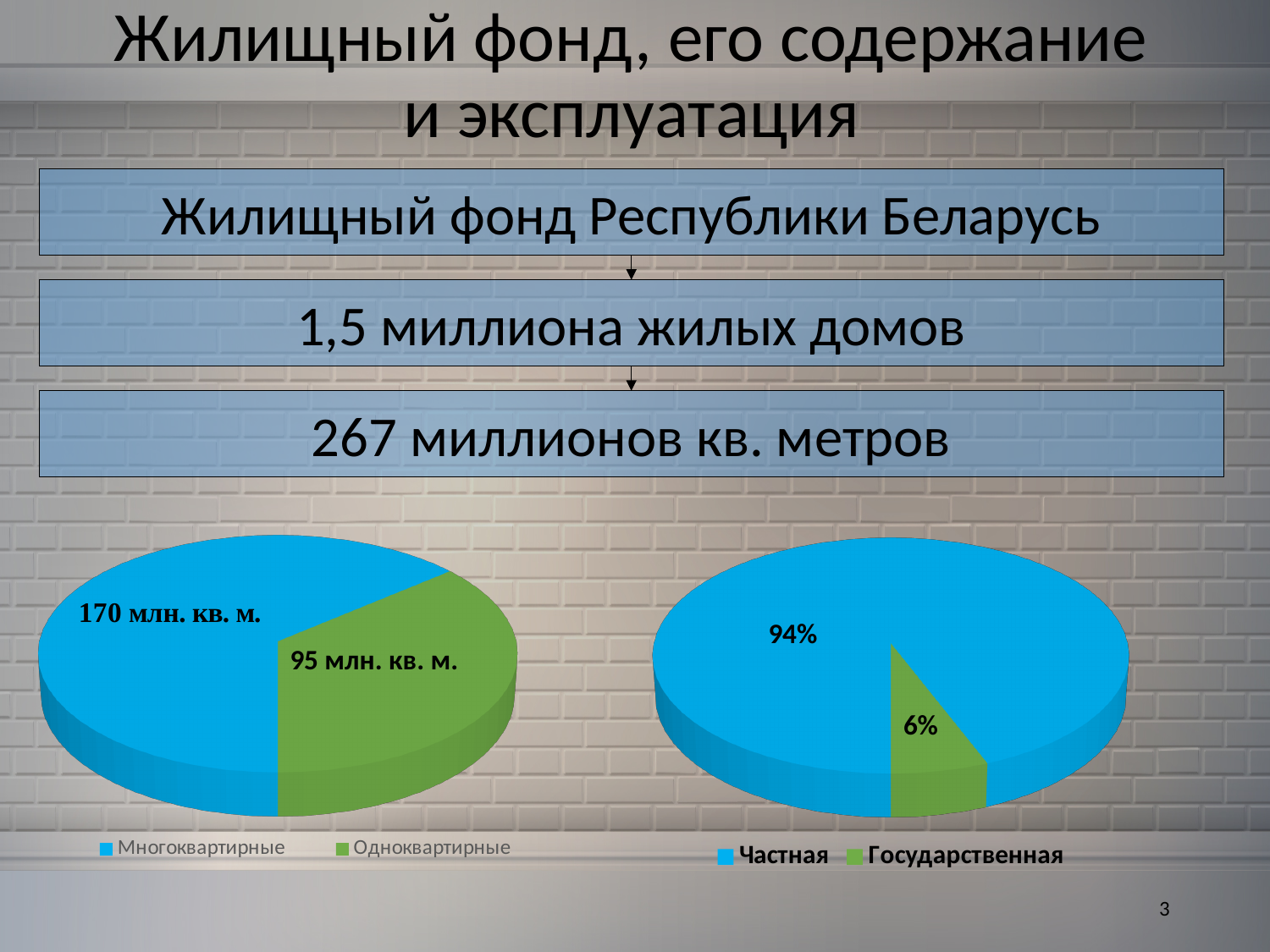
What kind of chart is the right chart on the slide? pie chart In the right pie chart, which category has the smallest share? Государственная In the left pie chart, which category has the larger value? Многоквартирные In the left pie chart, what is the value for Одноквартирные? 95 млн. кв. м. In the left pie chart, what is the difference between the values for Многоквартирные and Одноквартирные? 75 млн. кв. м. In the left pie chart, what is the value for Многоквартирные? 170 млн. кв. м. How many slices does the left pie chart have? 2 What are the legend entries of the right pie chart? Частная, Государственная In the right pie chart, what share is labelled for Частная? 94% What kind of chart is the left chart on the slide? pie chart In the right pie chart, which is larger: Частная or Государственная? Частная In the right pie chart, what share is labelled for Государственная? 6%